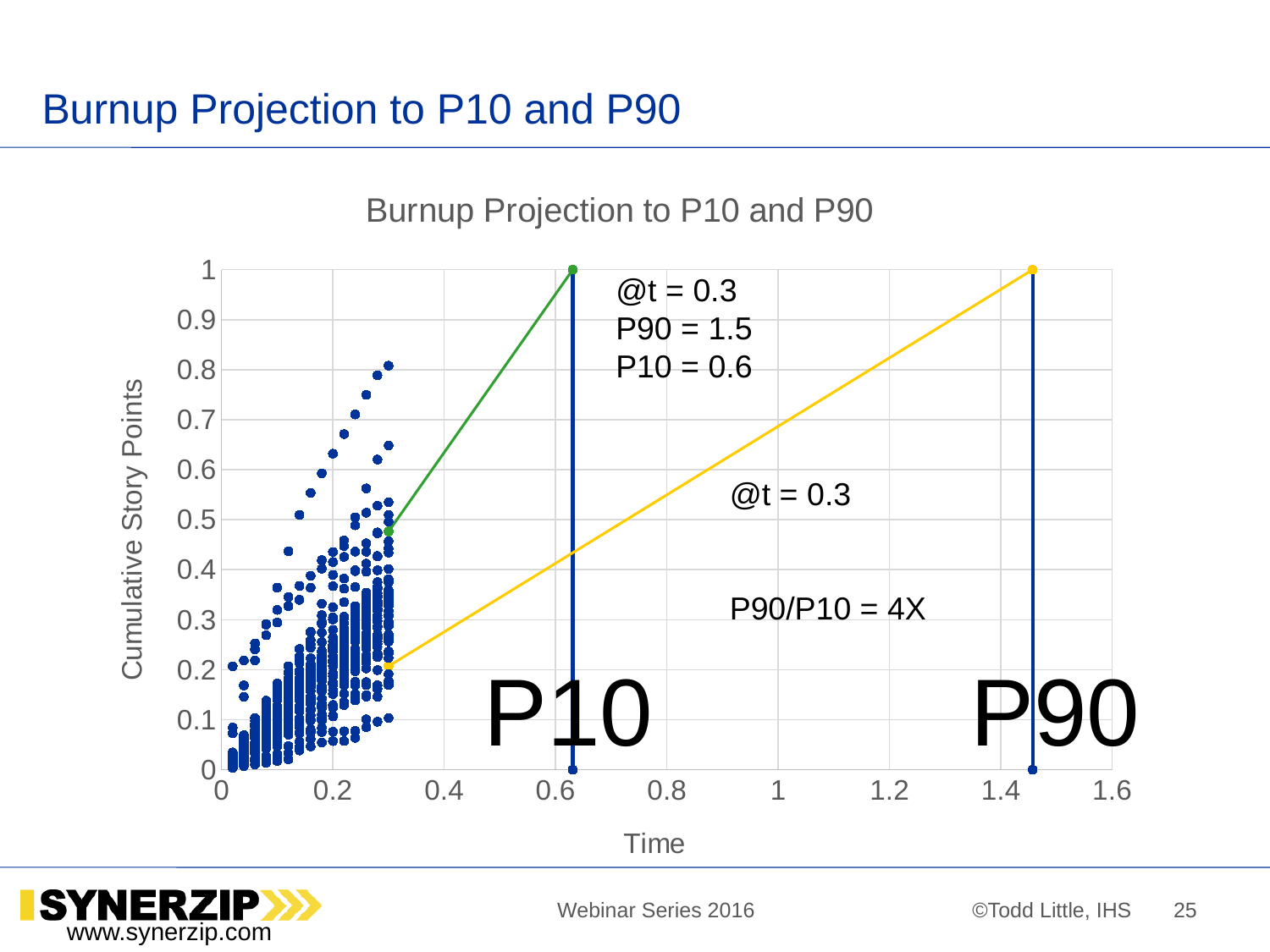
What is the difference between the P90 and P10 values at t = 0.3? 0.9 Which is larger at t = 0.3, the P90 value or the P10 value? P90 Is the time at which the P10 vertical line is drawn greater or less than 0.8? less What is the title of the chart? Burnup Projection to P10 and P90 What is the largest value shown on the Time axis? 1.6 What kind of chart is shown on the slide? scatter chart What is the label of the vertical axis of the chart? Cumulative Story Points Is the time at which the P90 vertical line is drawn greater or less than 1.4? greater According to the annotation, what is the P90 value at t = 0.3? 1.5 What is the ratio P90/P10 stated on the chart? 4X Is the highest scatter data point's cumulative story points value greater or less than 0.9? less According to the annotation, what is the P10 value at t = 0.3? 0.6